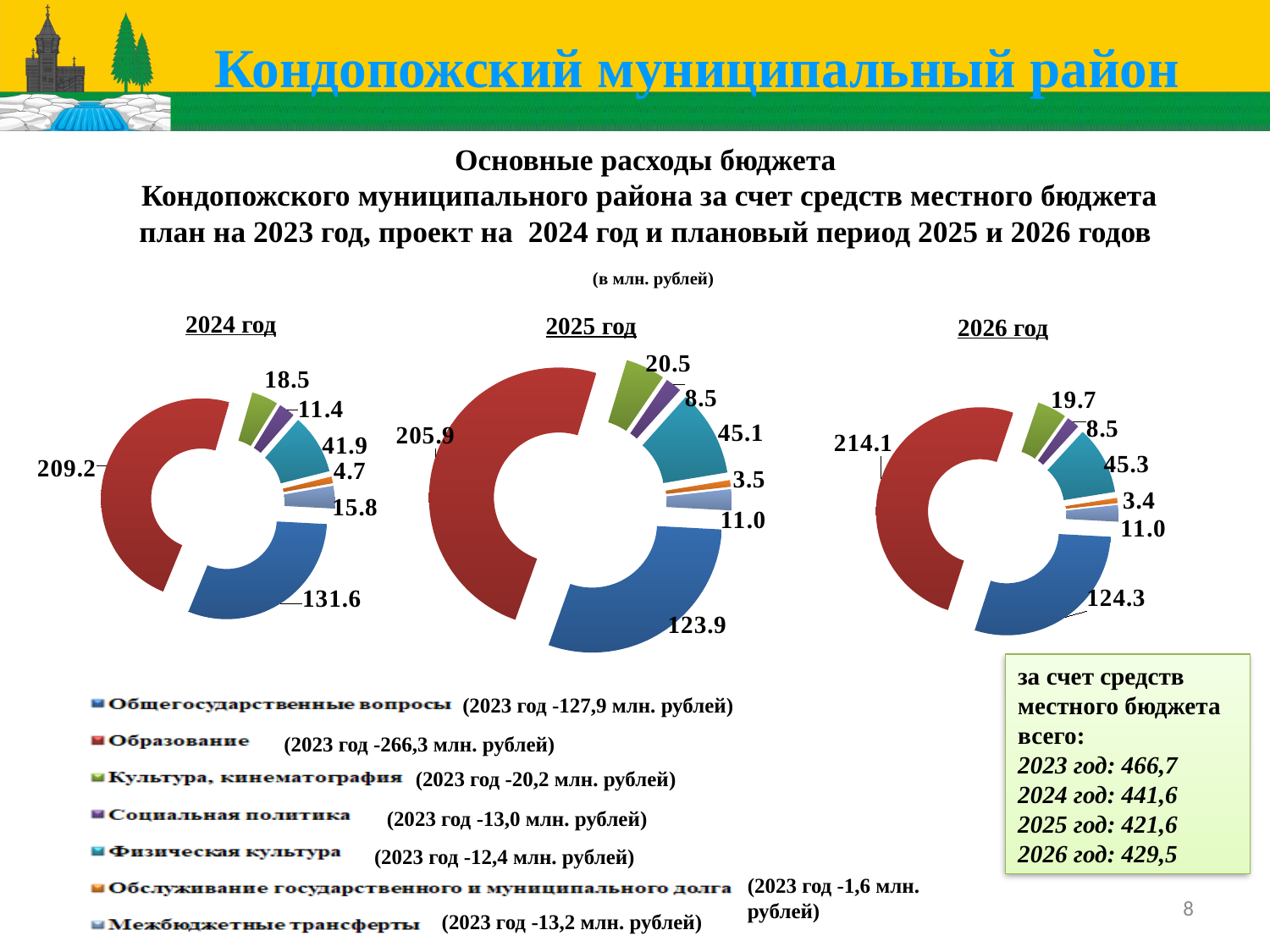
In the 2026 год chart, which category has the smallest value? Обслуживание государственного и муниципального долга In the 2025 год chart, which category has the largest value? Образование In the 2025 год chart, which is larger: Культура, кинематография or Социальная политика? Культура, кинематография In the 2024 год chart, what is the value for Межбюджетные трансферты? 15.8 How many categories does the legend list? 7 In the 2025 год chart, what is the value for Общегосударственные вопросы? 123.9 In the 2026 год chart, what is the value for Физическая культура? 45.3 In the 2024 год chart, what is the value for Образование? 209.2 What colour represents Образование in the charts? Red How many charts are shown on the slide? 3 In the 2024 год chart, what is the difference between the values for Образование and Общегосударственные вопросы? 77.6 What type of chart is used for the 2024 год data? Doughnut (pie) chart